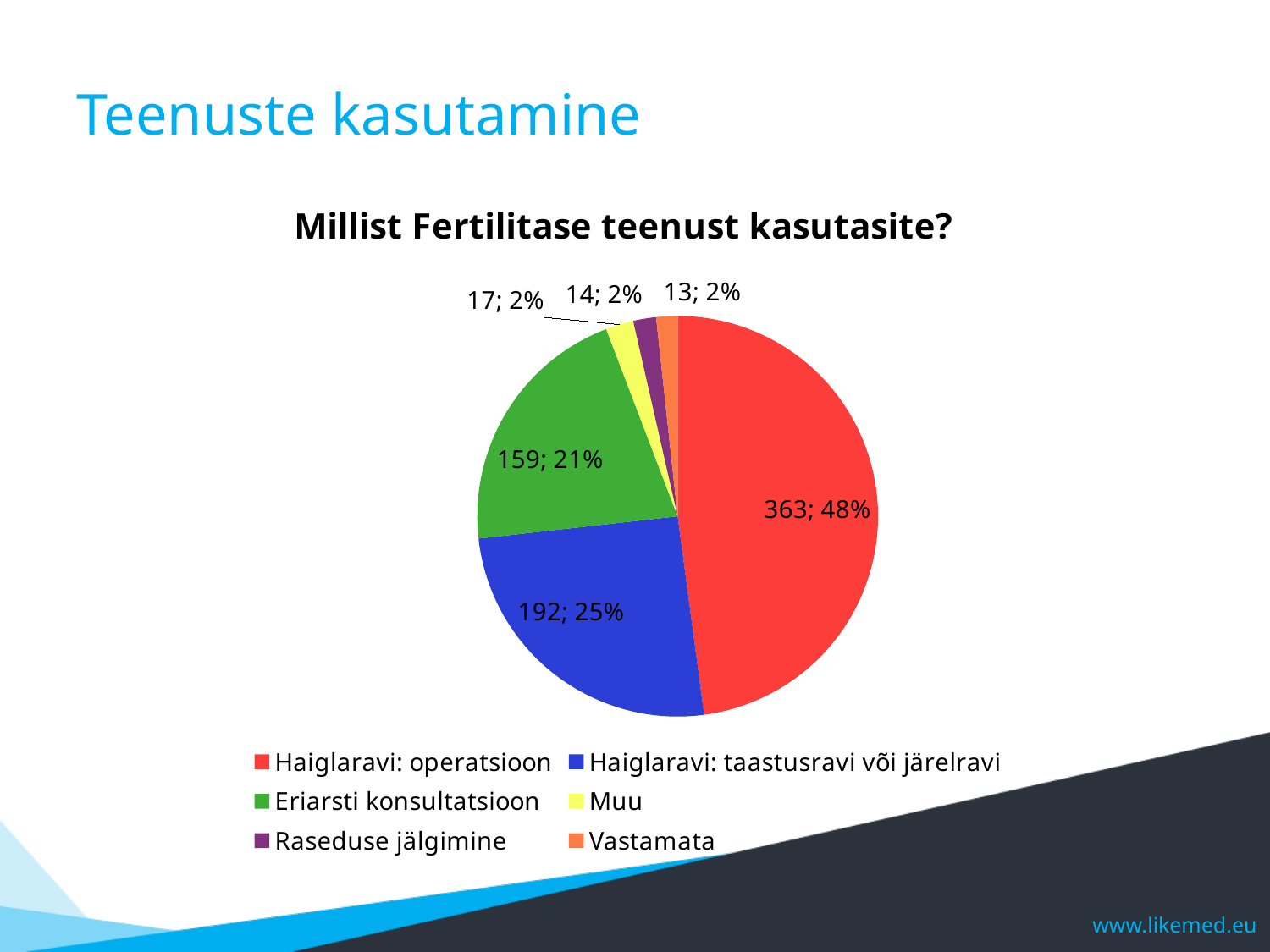
What is the difference between the counts for Haiglaravi: operatsioon and Haiglaravi: taastusravi või järelravi? 171 Which is larger, the count for Haiglaravi: taastusravi või järelravi or for Eriarsti konsultatsioon? Haiglaravi: taastusravi või järelravi What is the title of the chart? Millist Fertilitase teenust kasutasite? Which category has the smallest slice of the pie? Vastamata What is the value shown for Haiglaravi: operatsioon? 363; 48% What is the value shown for Eriarsti konsultatsioon? 159; 21% Which category has the largest slice of the pie? Haiglaravi: operatsioon How many slices does the pie chart have? 6 What kind of chart is shown on the slide? pie chart What share of the pie does Eriarsti konsultatsioon represent? 21% What is the value shown for Muu? 17; 2% What is the value shown for Haiglaravi: taastusravi või järelravi? 192; 25%